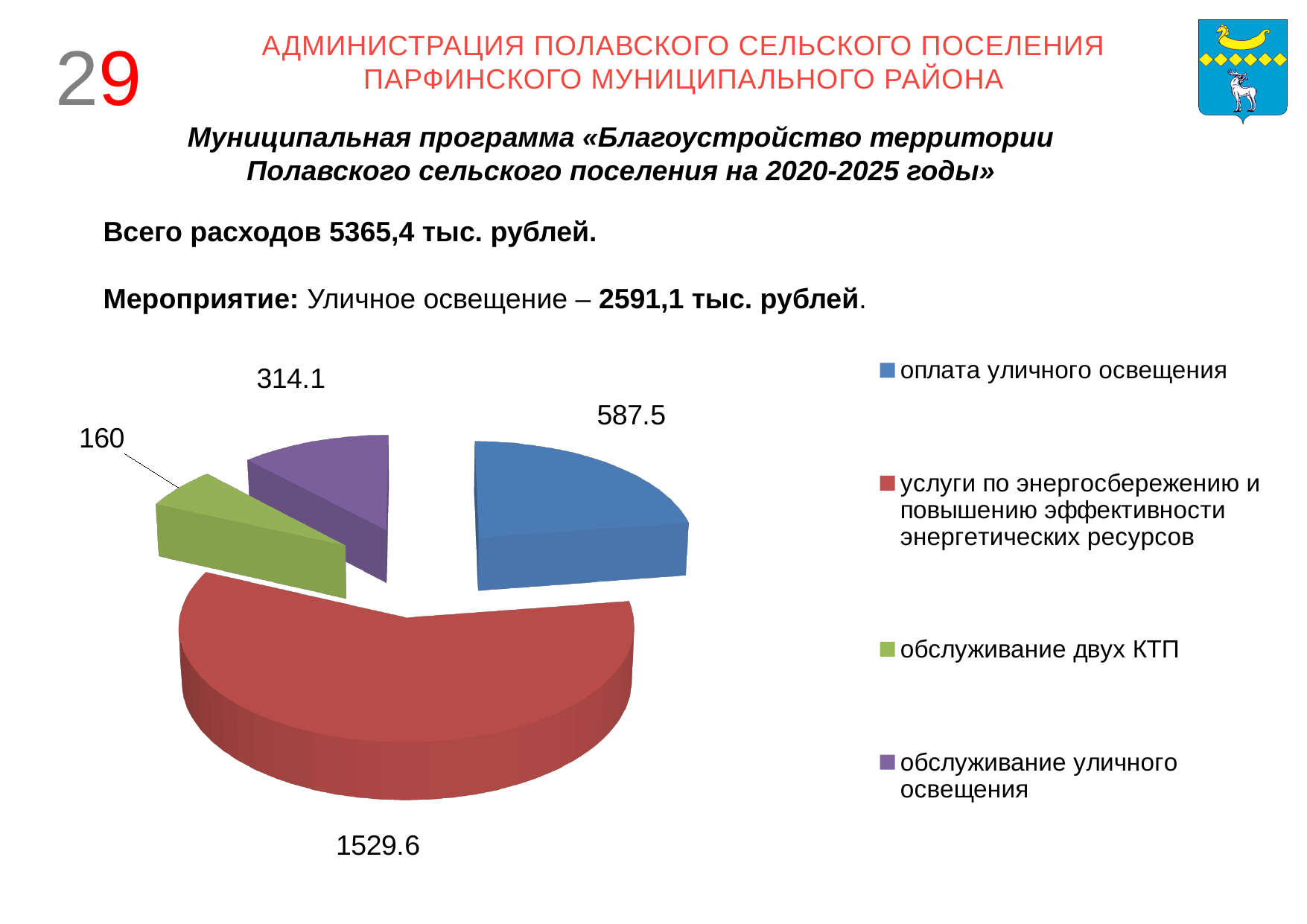
What is the value for «обслуживание двух КТП» in the pie chart? 160 Which category has the smallest slice in the pie chart? обслуживание двух КТП What type of chart is shown on the slide? pie chart Which is larger: the value for «оплата уличного освещения» or the value for «обслуживание уличного освещения»? оплата уличного освещения What is the difference between the values for «услуги по энергосбережению и повышению эффективности энергетических ресурсов» and «оплата уличного освещения»? 942.1 What is the value for «оплата уличного освещения» in the pie chart? 587.5 What is the difference between the values for «обслуживание уличного освещения» and «обслуживание двух КТП»? 154.1 What is the value for «обслуживание уличного освещения» in the pie chart? 314.1 What colour is the slice for «обслуживание двух КТП»? green How many slices does the pie chart have? 4 What is the value for «услуги по энергосбережению и повышению эффективности энергетических ресурсов» in the pie chart? 1529.6 Which category has the largest slice in the pie chart? услуги по энергосбережению и повышению эффективности энергетических ресурсов